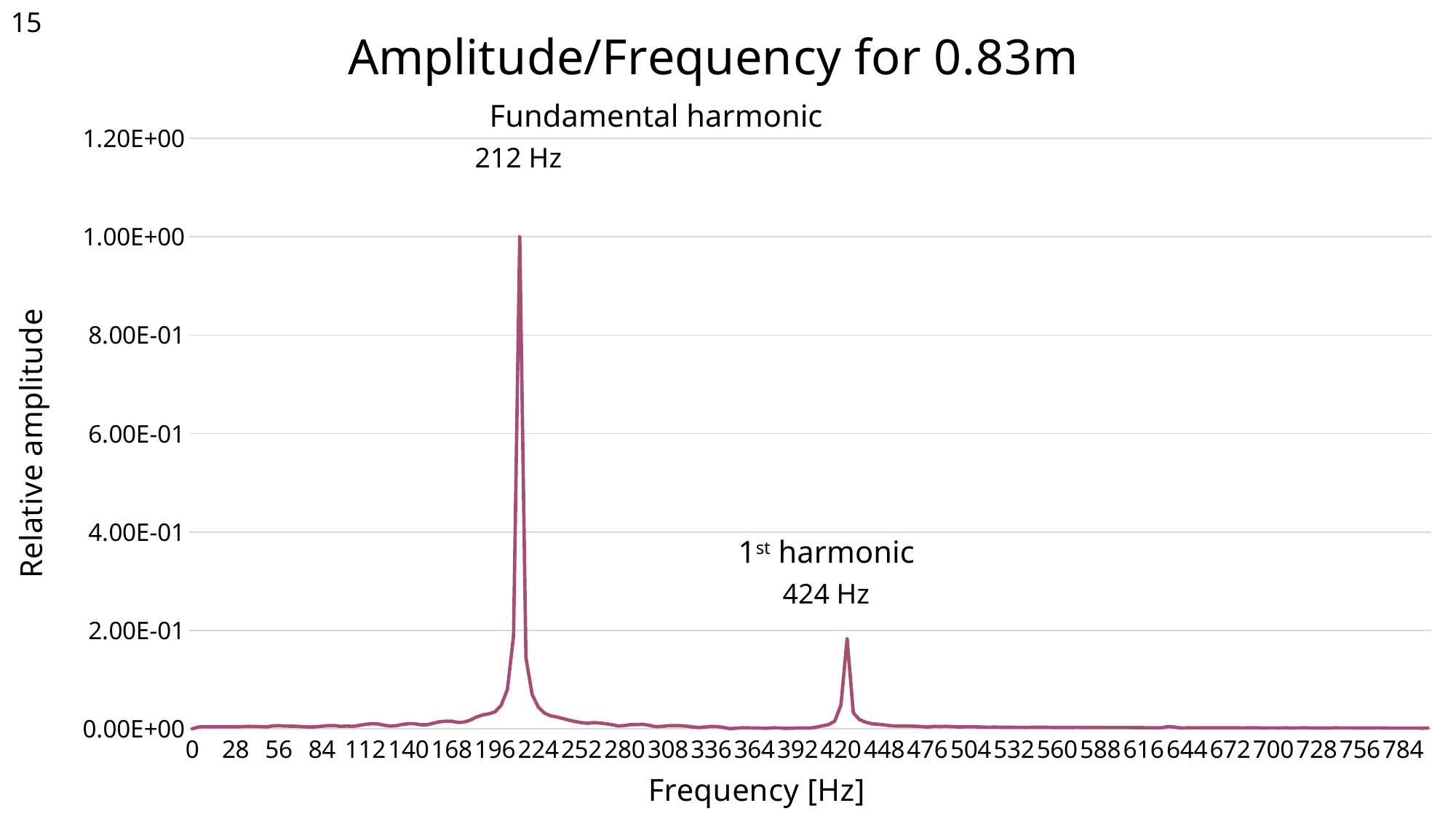
At what frequency is the fundamental harmonic labelled? 212 Hz At what frequency is the 1st harmonic labelled? 424 Hz Is the relative amplitude of the 1st harmonic peak at 424 Hz greater or less than 2.00E-01? less What is the relative amplitude of the peak at 212 Hz? 1.00E+00 How many harmonic peaks are labelled on the chart? 2 Does the relative amplitude rise or fall between 212 Hz and 300 Hz? fall What kind of chart is shown on the slide? line chart Is the relative amplitude of the peak at 212 Hz greater or less than 8.00E-01? greater What is the label of the x axis? Frequency [Hz] At which labelled frequency does the relative amplitude reach its highest value? 212 Hz Which peak has the larger relative amplitude, the fundamental harmonic at 212 Hz or the 1st harmonic at 424 Hz? fundamental harmonic at 212 Hz What is the title of the chart? Amplitude/Frequency for 0.83m